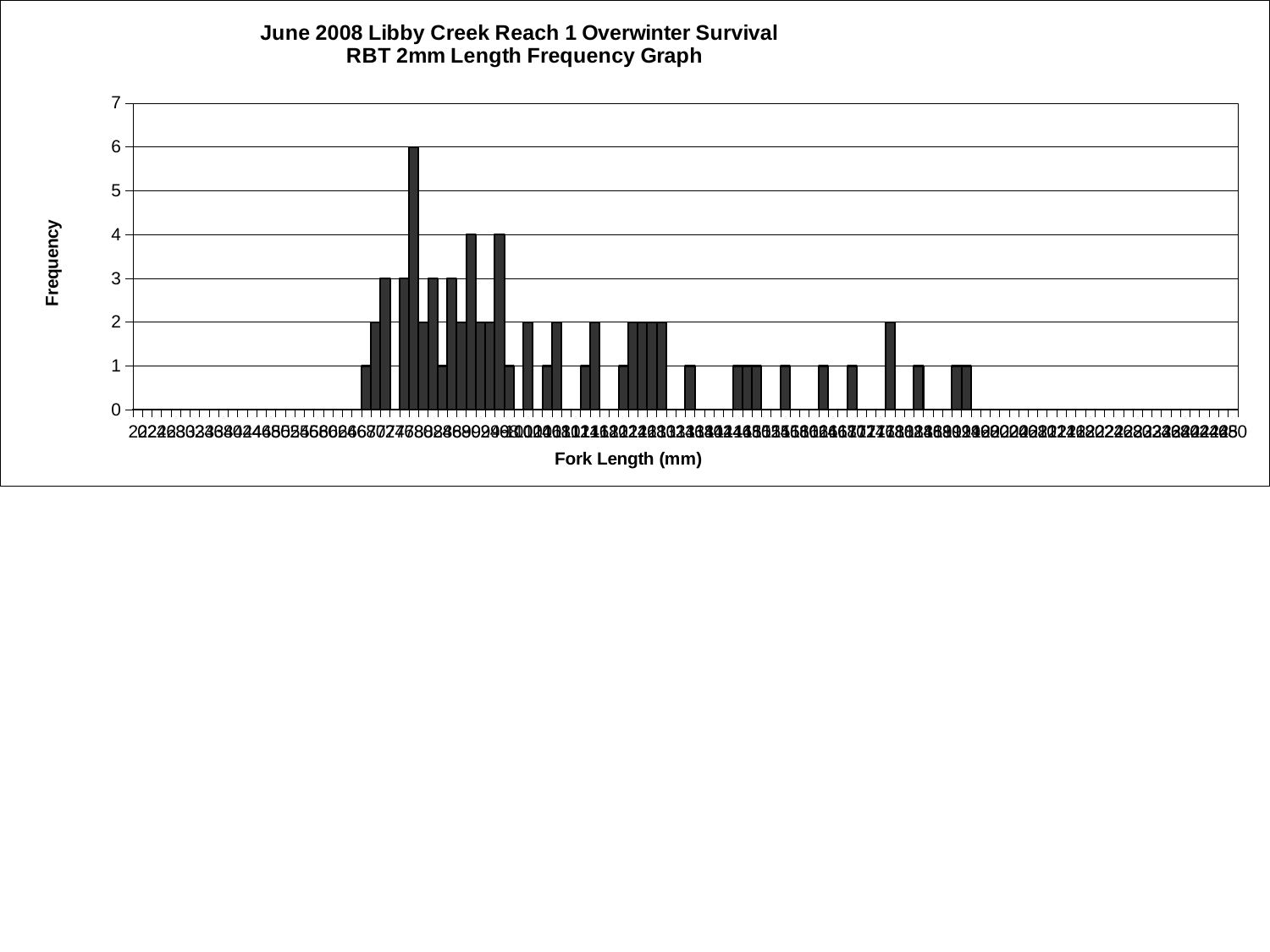
What is the highest frequency reached by any bar in the chart? 6 What is the label on the horizontal axis of the chart? Fork Length (mm) What kind of chart is shown on the slide? bar chart How many bars in the chart reach a frequency of 6? 1 Is the tallest bar in the chart greater or less than 5? greater How many bars in the chart reach a frequency of 4? 2 What is the label on the vertical axis of the chart? Frequency